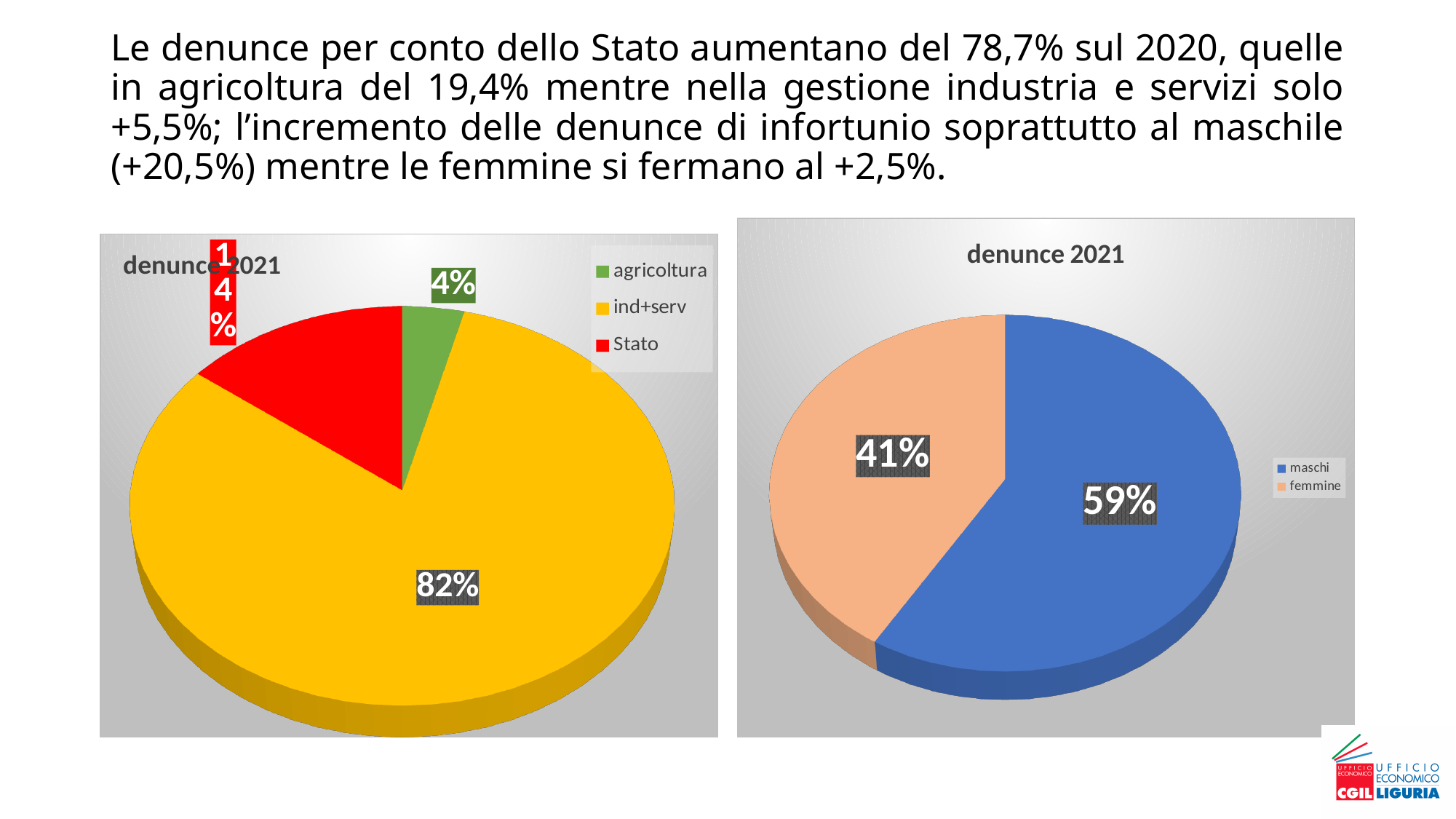
In the right pie chart, which is larger, maschi or femmine? maschi In the right pie chart, what share of denunce 2021 is maschi? 59% In the left pie chart, what is the difference in percentage points between Stato and agricoltura? 10 What type of chart is the right chart? pie chart In the left pie chart, what share of denunce 2021 is Stato? 14% In the left pie chart, which category has the largest slice? ind+serv In the left pie chart, how many categories are shown? 3 In the left pie chart, what share of denunce 2021 is agricoltura? 4% In the right pie chart, what is the difference in percentage points between maschi and femmine? 18 In the left pie chart, which category has the smallest slice? agricoltura